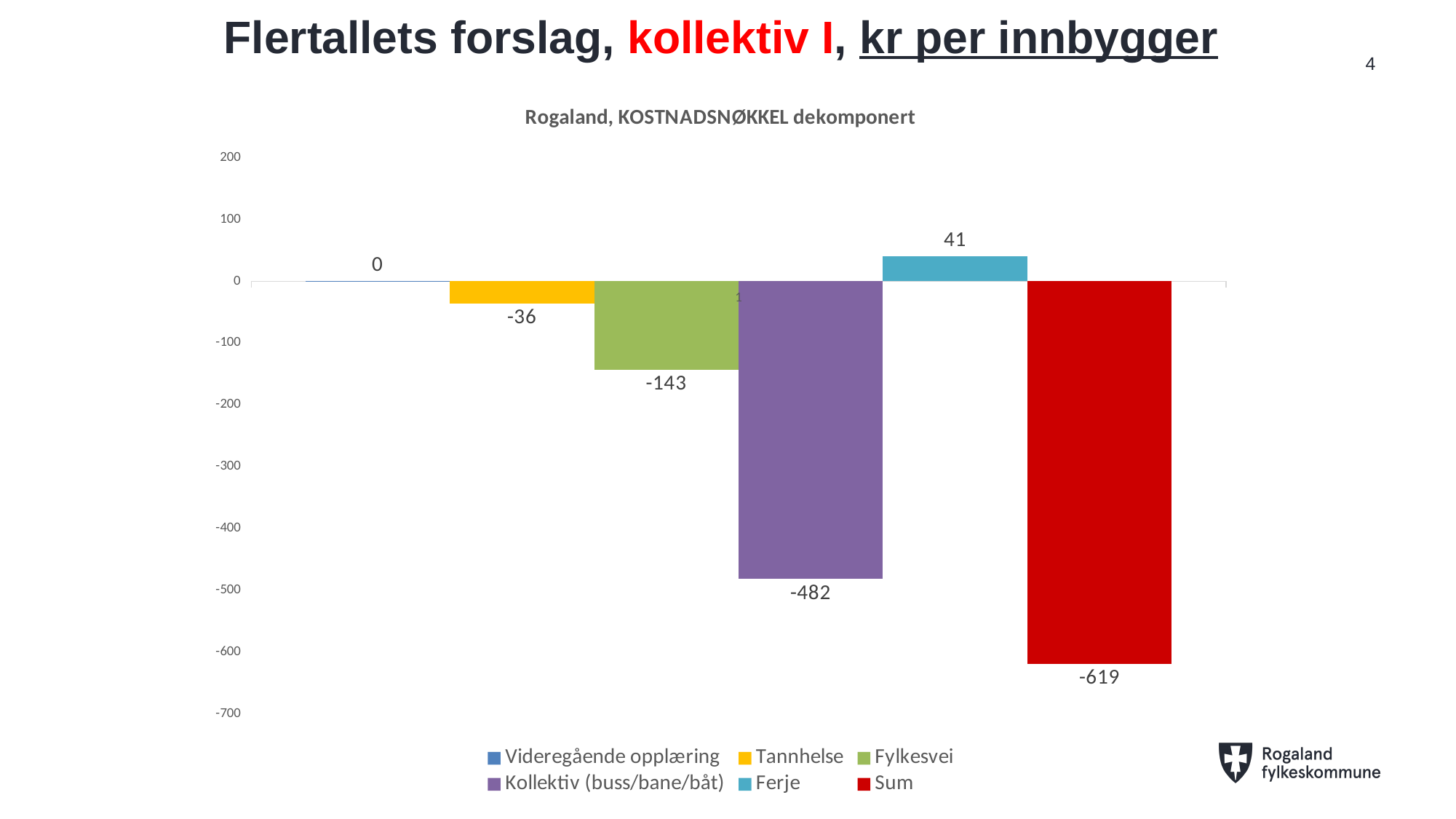
What is the value for Sum? -619 Which series has the lowest value? Sum What is the value for Kollektiv (buss/bane/båt)? -482 What is the difference between the values for Kollektiv (buss/bane/båt) and Fylkesvei? 339 What is the value for Tannhelse? -36 What is the title of the chart? Rogaland, KOSTNADSNØKKEL dekomponert What is the value for Fylkesvei? -143 What kind of chart is shown on the slide? Bar chart Which is larger, the value for Tannhelse or the value for Fylkesvei? Tannhelse Which series has the highest value? Ferje What is the value for Ferje? 41 How many series does the legend list? 6